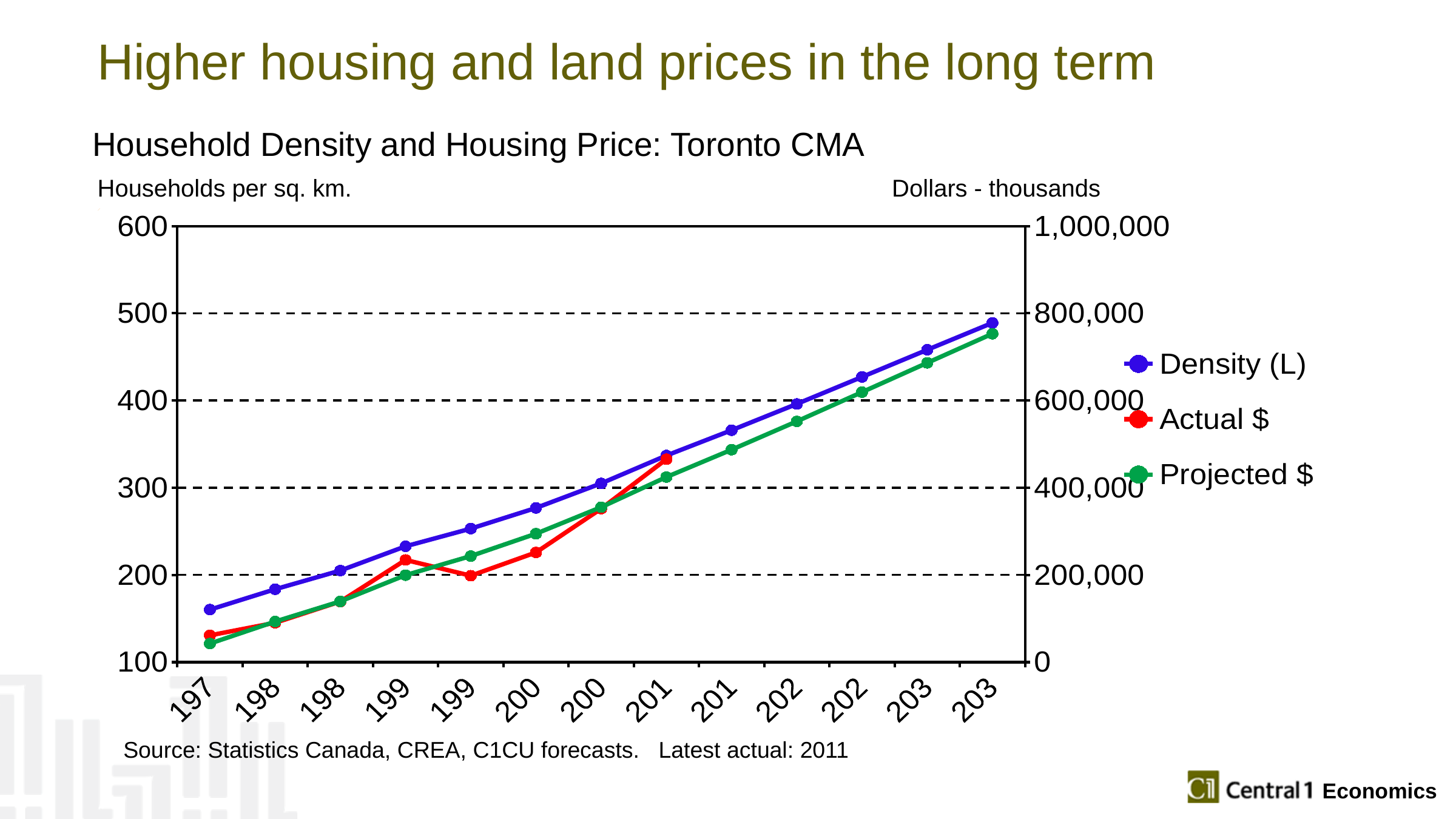
Is the Density (L) value at the rightmost point greater or less than 400 households per sq. km.? greater Is the Actual $ value at the leftmost point greater or less than 200,000? less Does the Projected $ series rise or fall from left to right along the x axis? rise How many points are plotted along the x axis for the Density (L) series? 13 Is the Density (L) value at the leftmost point greater or less than 200 households per sq. km.? less How many series does the legend list? 3 What kind of chart is shown on the slide? line chart At the fifth point from the left, which is higher: Actual $ or Projected $? Projected $ Does the Density (L) series rise or fall from left to right along the x axis? rise What is the label of the right-hand vertical axis? Dollars - thousands What is the title of the chart? Household Density and Housing Price: Toronto CMA